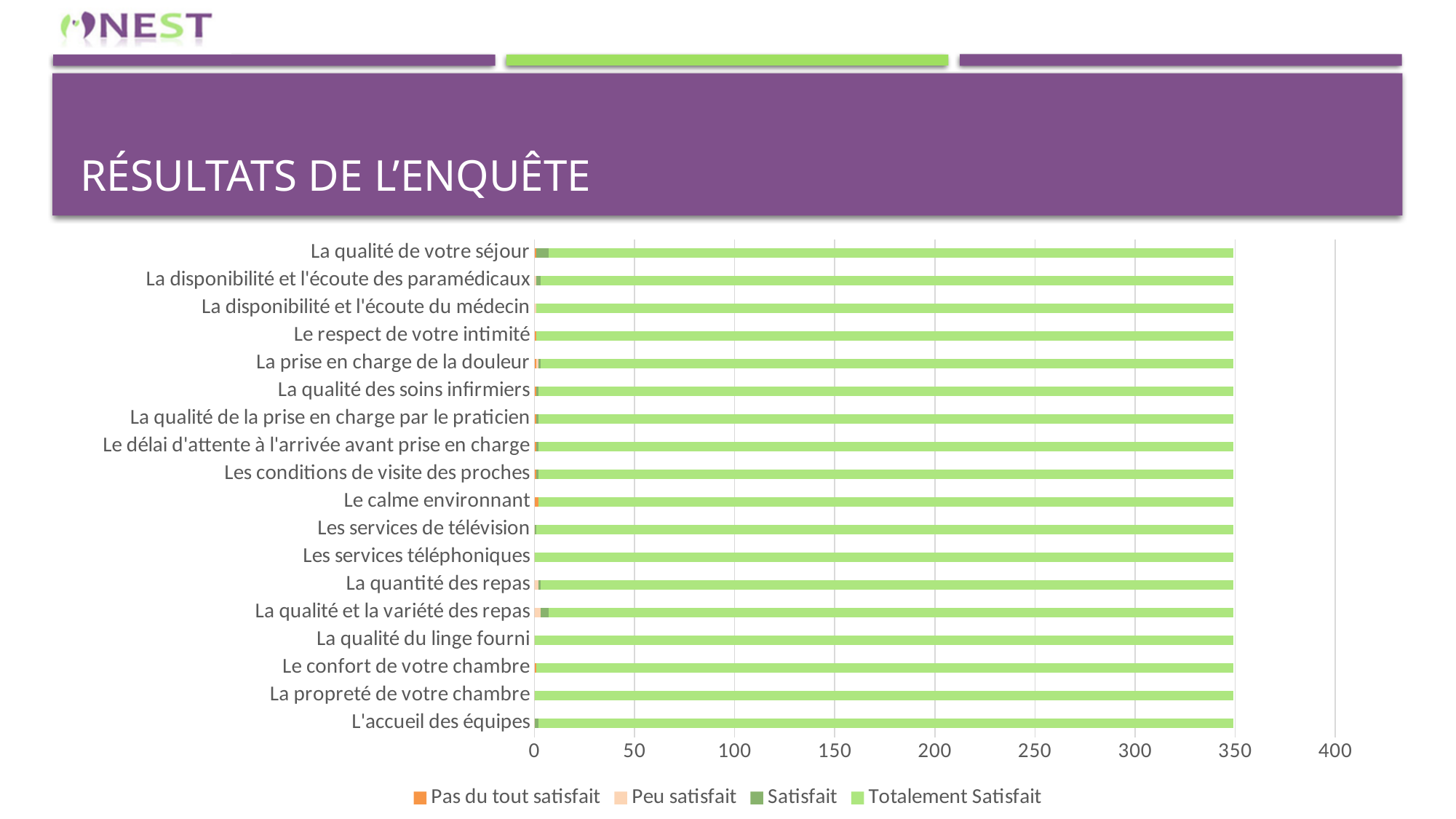
Is the total bar length for 'La propreté de votre chambre' greater or less than 300? greater What is the title shown above the chart on the slide? RÉSULTATS DE L'ENQUÊTE What is the highest tick value shown on the horizontal axis? 400 What kind of chart is shown on the slide? Stacked bar chart How many categories are listed on the vertical axis of the chart? 18 Which category appears at the top of the chart? La qualité de votre séjour How many series does the chart legend list? 4 Which series accounts for almost the entire length of every bar in the chart? Totalement Satisfait Is the total bar length for 'L'accueil des équipes' greater or less than 400? less Is the 'Totalement Satisfait' value for 'Le calme environnant' greater or less than 250? greater